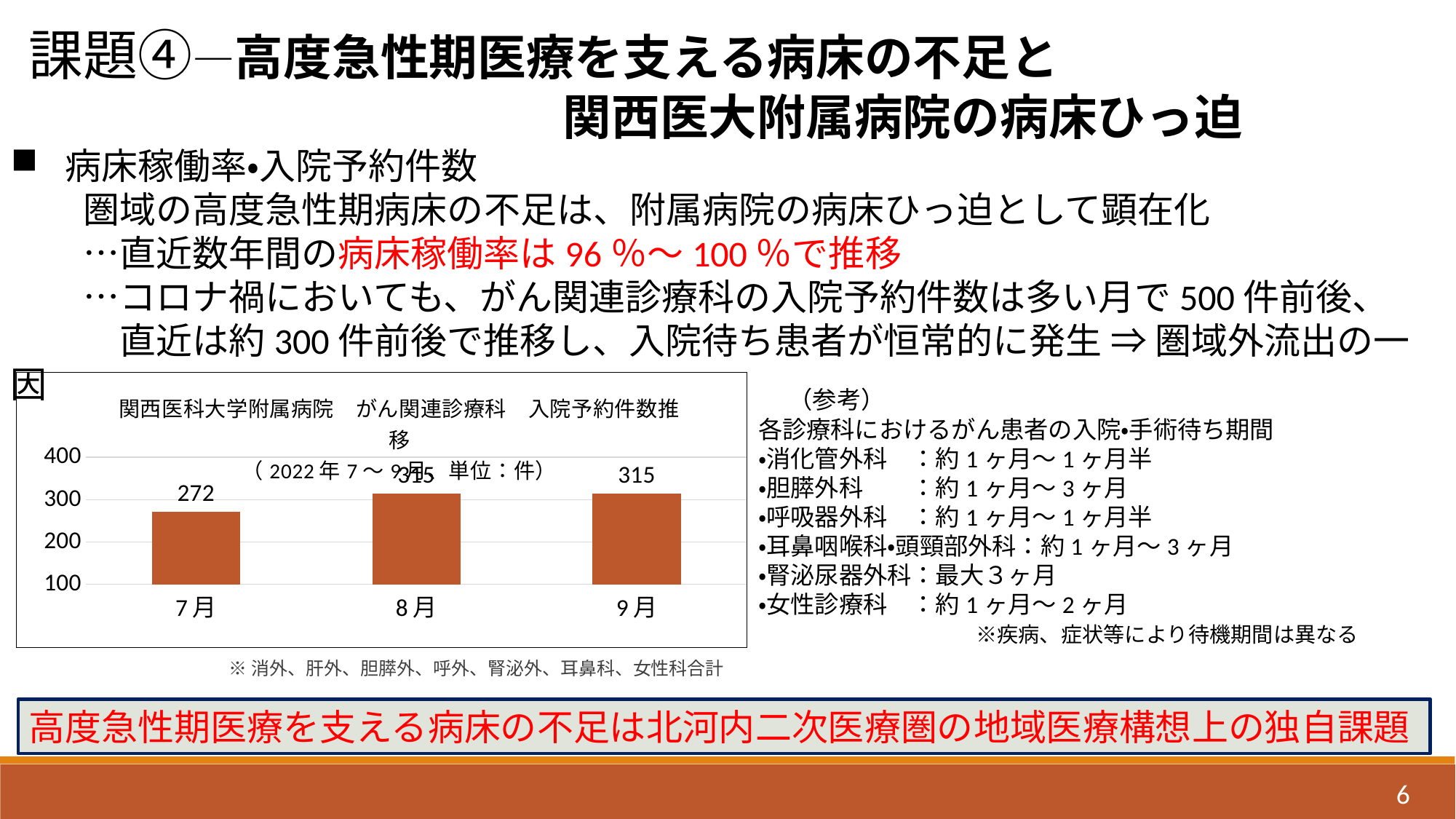
What is the value for 9月 in the chart? 315 Is the value for 9月 greater or less than 300? greater What unit is stated in the chart title? 件 What colour are the bars in the chart? brown (orange-brown) What kind of chart is shown on the slide? bar chart What is the difference between the values for 9月 and 7月? 43 What is the value for 7月 in the chart? 272 Do the values rise or fall from 7月 to 9月? rise Is the value for 7月 greater or less than 300? less How many months are shown on the x axis of the chart? 3 Which is larger, the value for 7月 or the value for 9月? 9月 Which month has the lowest value in the chart? 7月